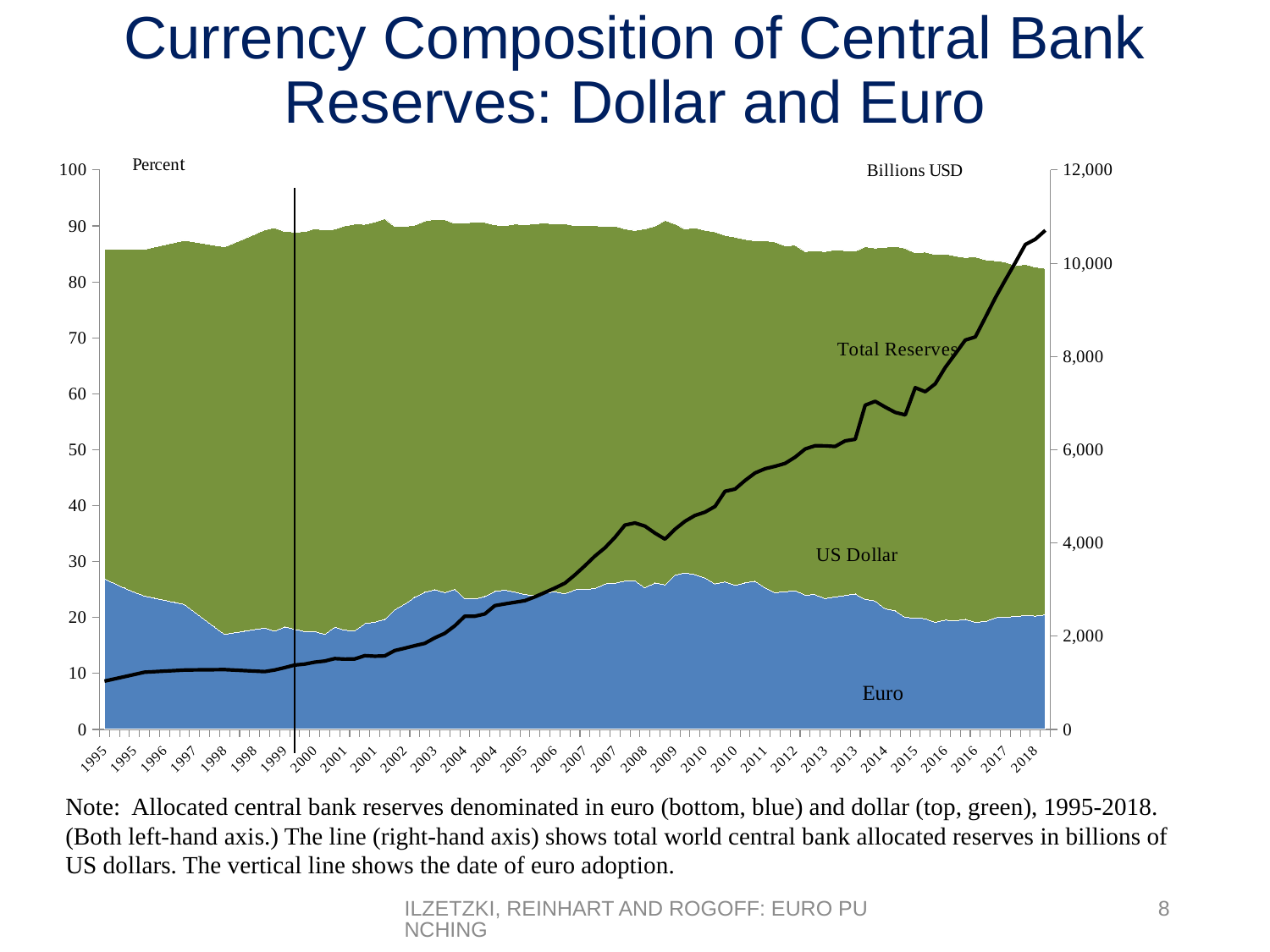
How many data series are plotted on the chart? 3 What kind of chart is shown on the slide? A stacked area chart with a line Does the Total Reserves line rise or fall overall from 1995 to 2018? rise Is the Euro share of reserves in 1998 greater or less than 20 percent? less Is the Euro share of reserves in 1995 greater or less than 20 percent? greater Is the Total Reserves value in 2018 greater or less than 10,000 billions USD? greater Which series is shown in blue at the bottom of the chart? Euro In which year does the Total Reserves line reach its highest value? 2018 What is the label of the right-hand axis? Billions USD Is the Euro share of reserves larger in 1995 or in 1998? 1995